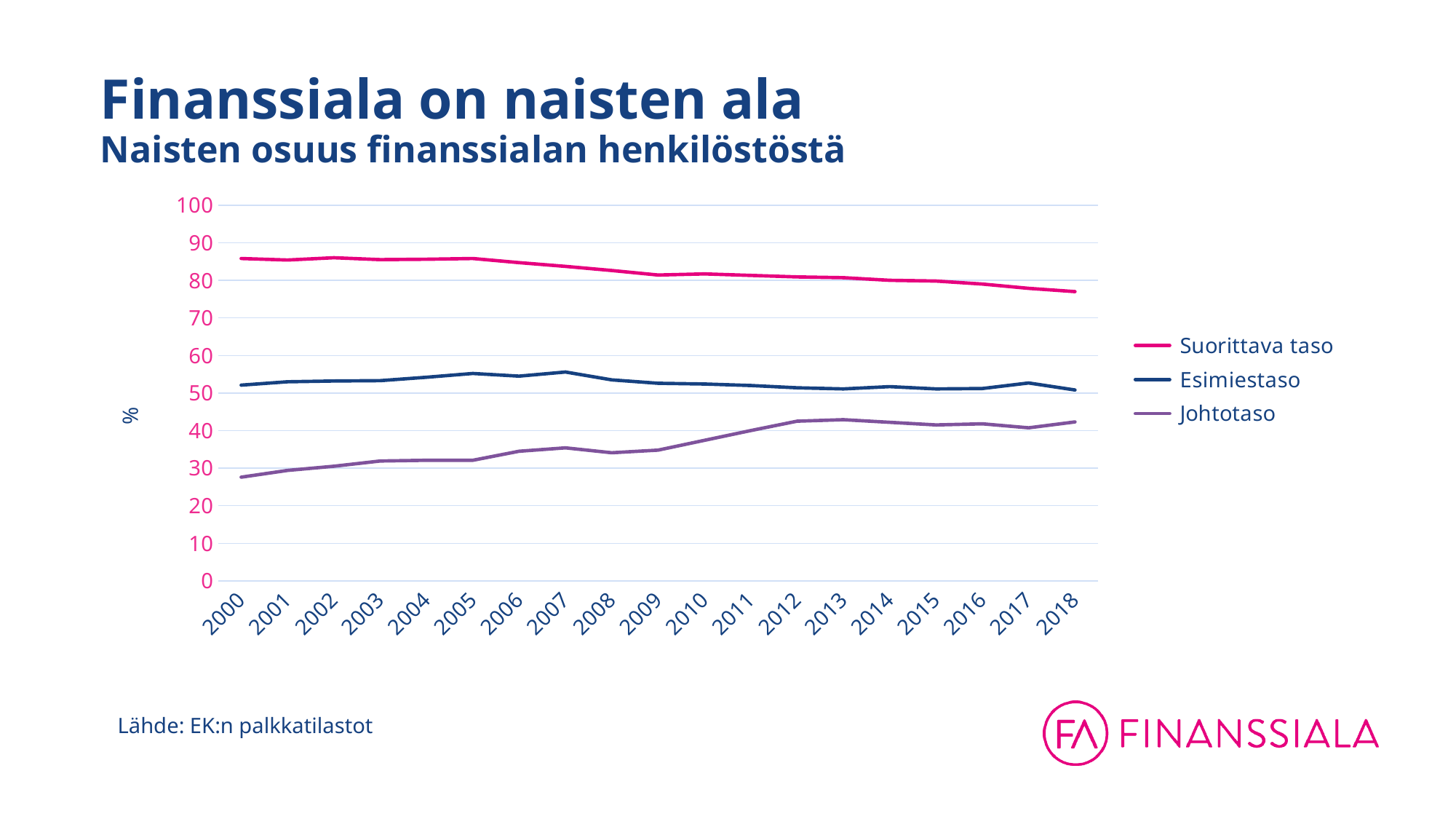
Is the value for Johtotaso in 2000 greater or less than 30? less Which series has the lowest value in 2000? Johtotaso What is the label on the y axis? % How many years are shown on the x axis? 19 What kind of chart is shown on the slide? line chart Is the value for Suorittava taso in 2000 greater or less than 80? greater How many series does the legend list? 3 Does the Johtotaso line rise or fall from 2000 to 2018? rise Does the Suorittava taso line rise or fall from 2000 to 2018? fall Is the value for Johtotaso in 2018 greater or less than 40? greater Which series has the highest values across all years? Suorittava taso